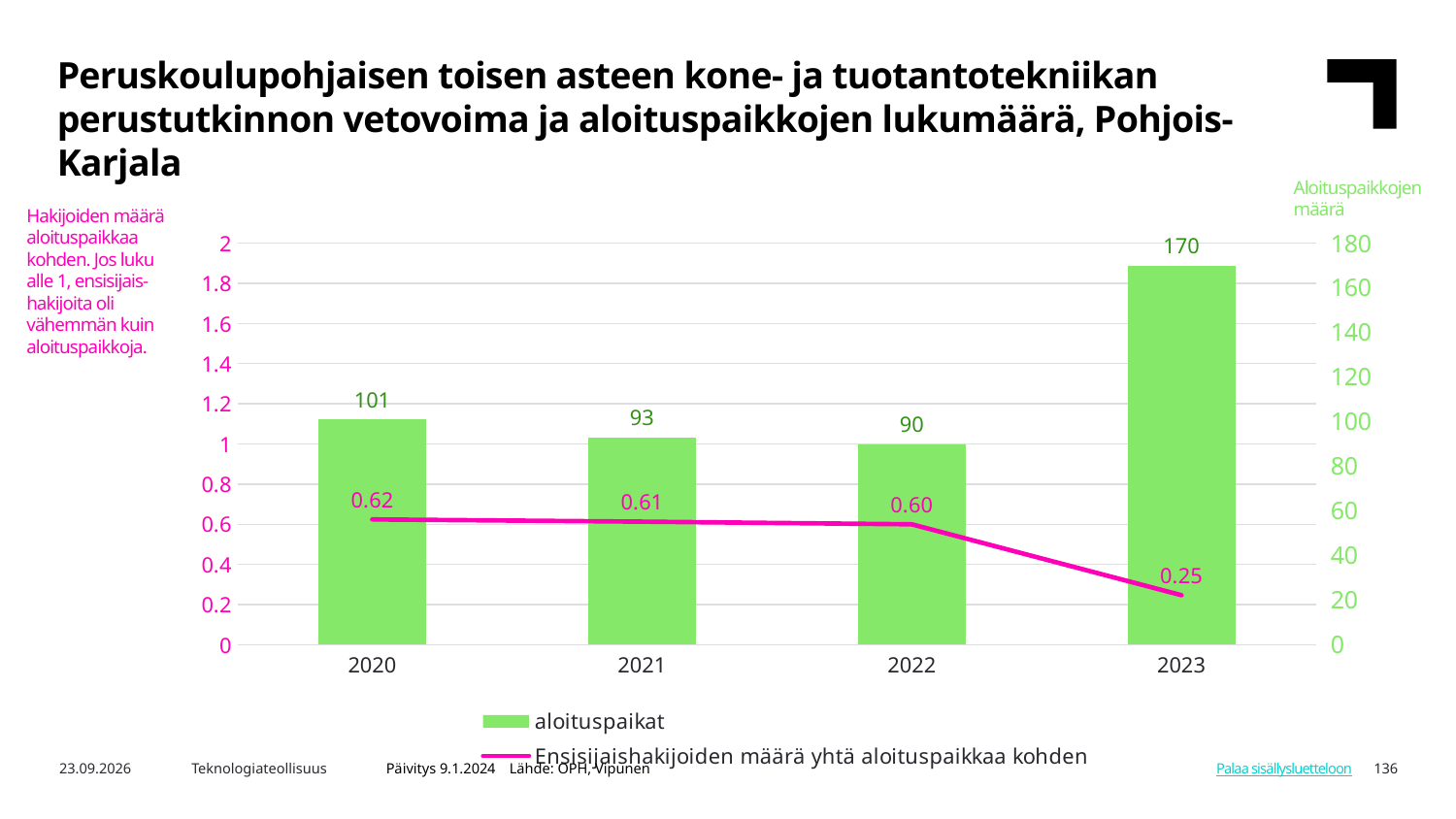
What is the value of aloituspaikat for 2021? 93 What is the value of Ensisijaishakijoiden määrä yhtä aloituspaikkaa kohden for 2023? 0.25 What is the difference between aloituspaikat in 2023 and 2022? 80 How many years are shown on the x axis? 4 What is the value of aloituspaikat for 2023? 170 What colour are the aloituspaikat bars? green Which is larger, aloituspaikat in 2020 or in 2021? 2020 Which year has the lowest value of aloituspaikat? 2022 What is the value of Ensisijaishakijoiden määrä yhtä aloituspaikkaa kohden for 2020? 0.62 Which year has the highest value of aloituspaikat? 2023 Does the Ensisijaishakijoiden määrä yhtä aloituspaikkaa kohden line rise or fall from 2020 to 2023? fall How many series does the legend list? 2